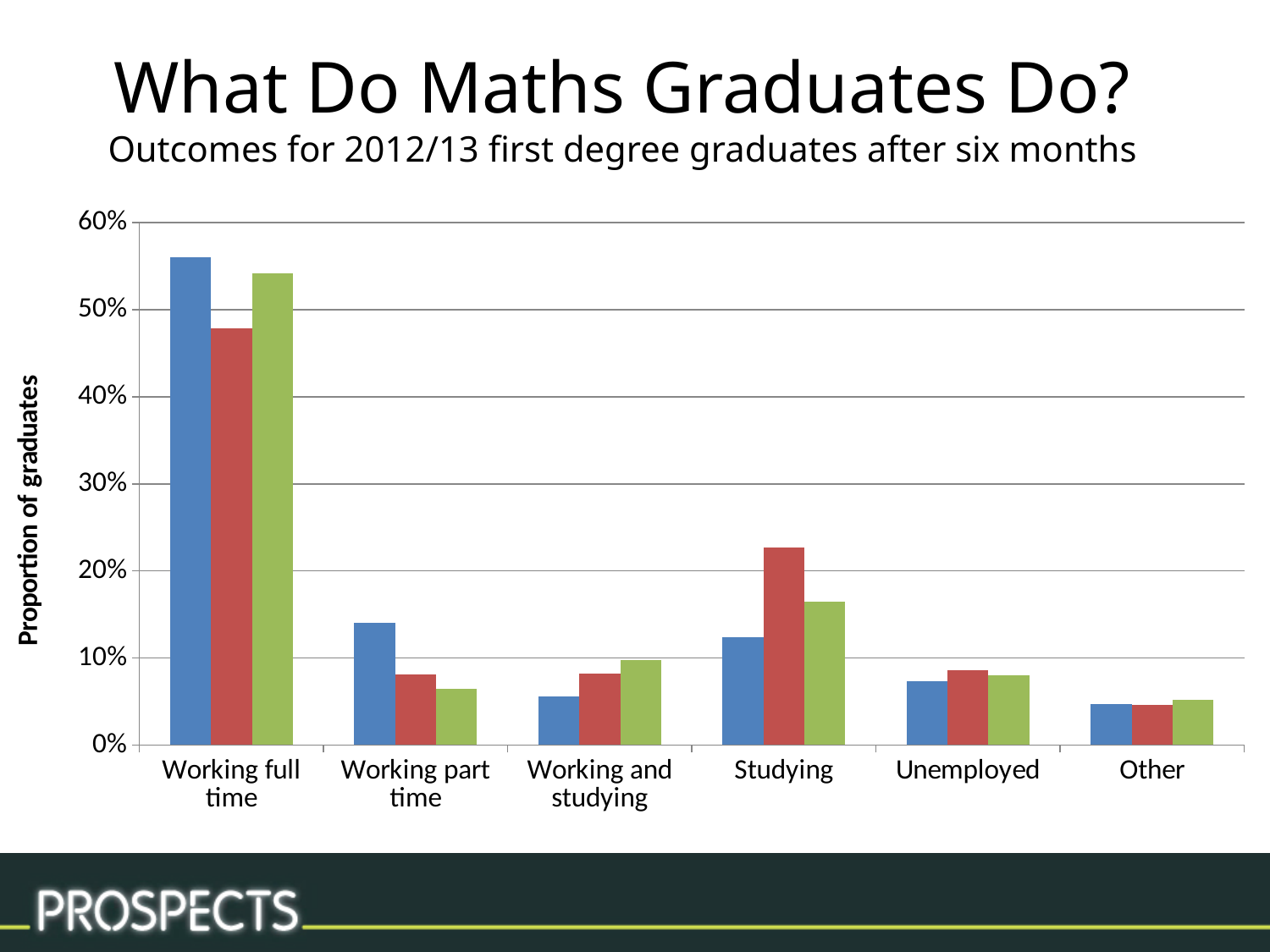
Is the value of the blue bar for Working part time greater or less than 10%? greater Is the value of the red bar for Working full time greater or less than 50%? less For Working full time, which bar is taller: the blue bar or the red bar? the blue bar How many outcome categories are shown along the x axis? 6 Is the value of the blue bar for Working full time greater or less than 50%? greater What is the label on the vertical axis? Proportion of graduates What kind of chart is shown on the slide? bar chart Which category has the tallest bars? Working full time Which category has the shortest bars overall? Other For Studying, which bar is taller: the blue bar or the red bar? the red bar